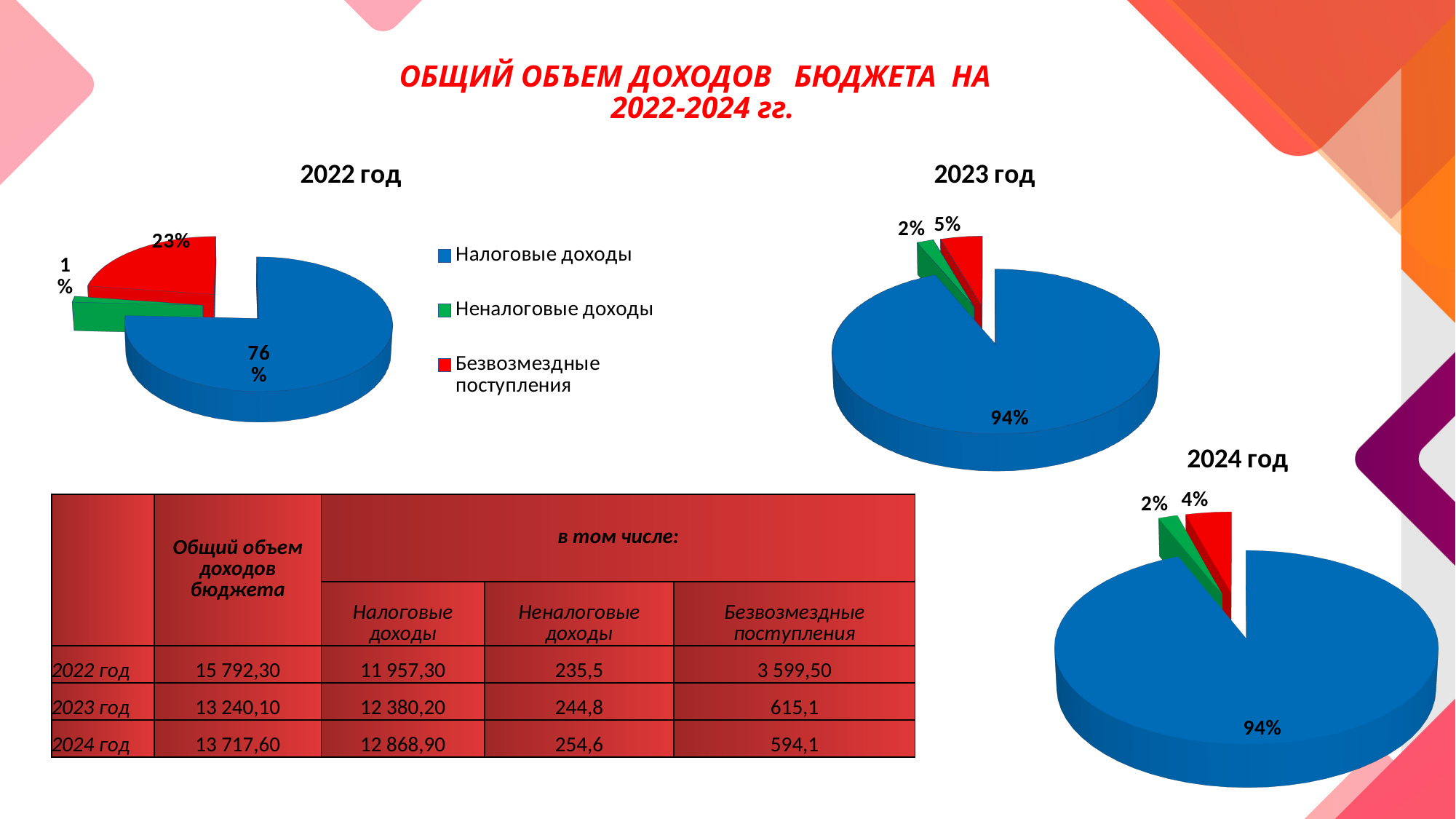
What kind of chart is used for the 2022 год chart? pie chart In the 2024 год pie chart, which category has the smallest share? Неналоговые доходы In the 2022 год pie chart, what share is shown for Неналоговые доходы? 1% In the 2022 год pie chart, what share is shown for Налоговые доходы? 76% Which colour represents Безвозмездные поступления in the pie charts? red How many categories does the legend list for the pie charts? 3 In the 2023 год pie chart, what share is shown for Безвозмездные поступления? 5% In the 2022 год pie chart, what is the difference between the shares of Налоговые доходы and Безвозмездные поступления? 53% In the 2022 год pie chart, which category has the largest share? Налоговые доходы